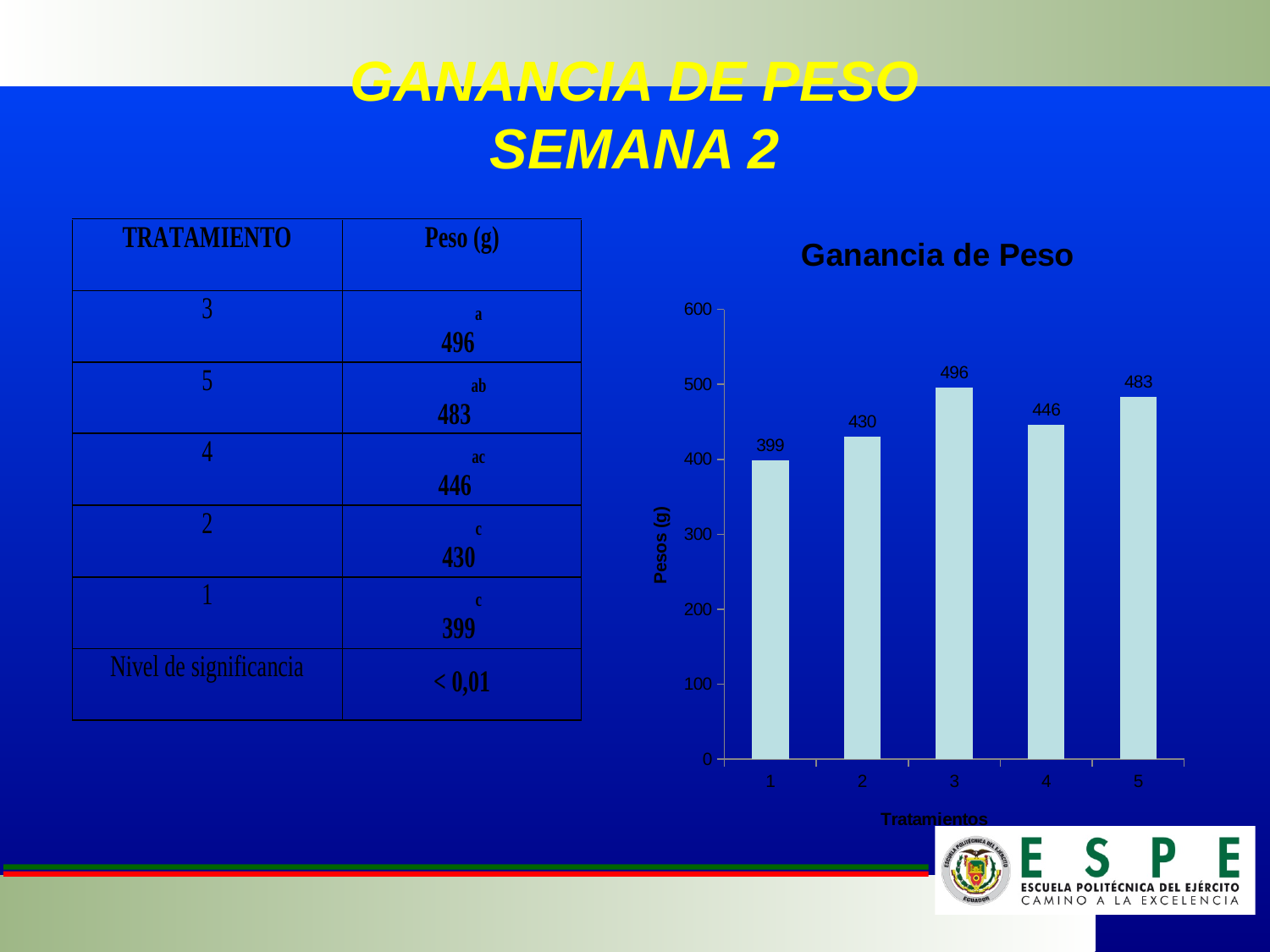
What is the value for treatment 3 in the Ganancia de Peso chart? 496 Is the value for treatment 2 in the Ganancia de Peso chart greater or less than 500? less Which treatment has the highest value in the Ganancia de Peso chart? 3 What is the value for treatment 1 in the Ganancia de Peso chart? 399 What kind of chart is the Ganancia de Peso chart? bar chart What is the y-axis label of the Ganancia de Peso chart? Pesos (g) How many treatments are shown on the x axis of the Ganancia de Peso chart? 5 What is the difference between the values for treatment 5 and treatment 4 in the Ganancia de Peso chart? 37 What is the difference between the values for treatment 3 and treatment 1 in the Ganancia de Peso chart? 97 Which treatment has the lowest value in the Ganancia de Peso chart? 1 Which is larger in the Ganancia de Peso chart, the value for treatment 2 or treatment 4? treatment 4 What is the value for treatment 5 in the Ganancia de Peso chart? 483